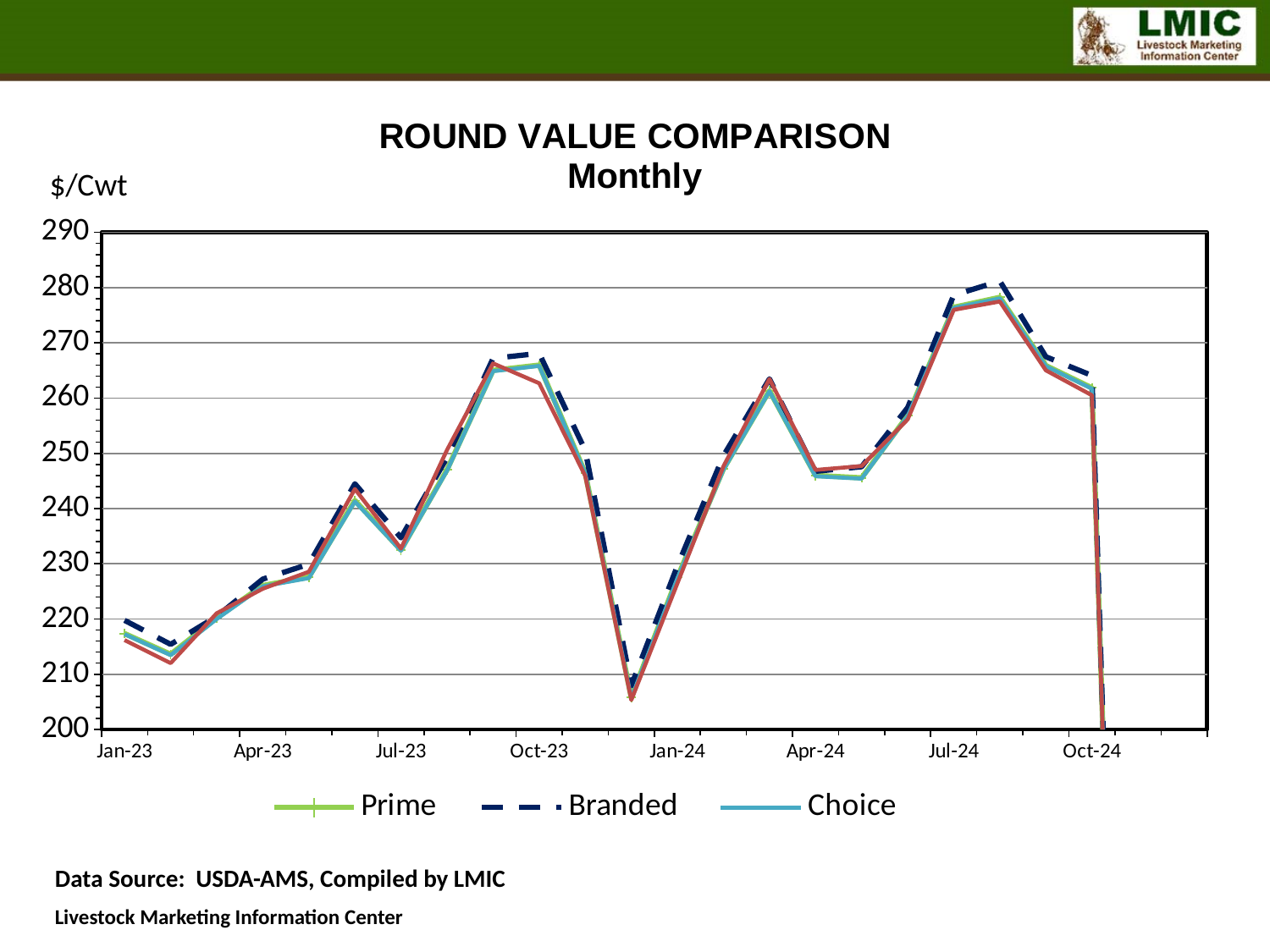
What kind of chart is shown on the slide? line chart Which series reaches the highest value on the chart? Branded Is the value for Prime at Oct-23 greater or less than 260? greater Do the values for Branded rise or fall between Oct-23 and Jan-24? fall What unit is shown on the y axis of the chart? $/Cwt Is the value for Branded at Apr-24 greater or less than 250? less How many series does the legend list? 3 Is the value for Choice at Apr-23 greater or less than 220? greater Do the values for Prime rise or fall from Jan-23 to Jul-23? rise What is the title of the chart? ROUND VALUE COMPARISON Monthly